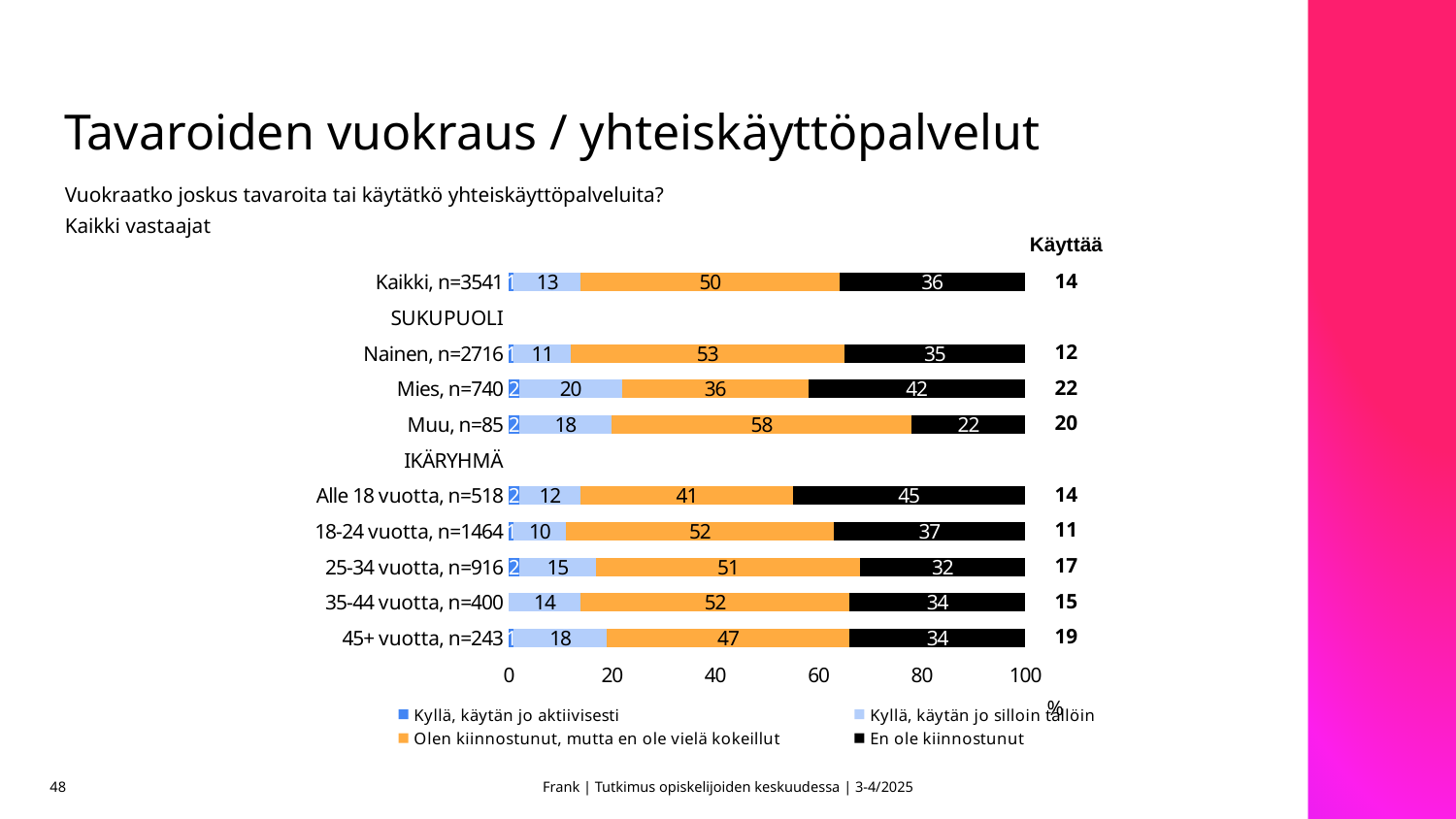
Which category has the highest 'Käyttää' figure? Mies, n=740 How many series does the legend list? 4 What is the value of 'Kyllä, käytän jo silloin tällöin' for 45+ vuotta, n=243? 18 What is the difference between the 'En ole kiinnostunut' values for Alle 18 vuotta, n=518 and 25-34 vuotta, n=916? 13 What is the value of 'Olen kiinnostunut, mutta en ole vielä kokeillut' for Kaikki, n=3541? 50 Which is larger: the 'Kyllä, käytän jo silloin tällöin' value for Mies, n=740 or for Nainen, n=2716? Mies, n=740 Which category has the lowest value for 'En ole kiinnostunut'? Muu, n=85 What is the value of 'Olen kiinnostunut, mutta en ole vielä kokeillut' for 18-24 vuotta, n=1464? 52 What is the value of 'En ole kiinnostunut' for Mies, n=740? 42 What is the 'Käyttää' figure shown for Mies, n=740? 22 Which category has the highest value for 'Olen kiinnostunut, mutta en ole vielä kokeillut'? Muu, n=85 What kind of chart is shown on the slide? stacked bar chart